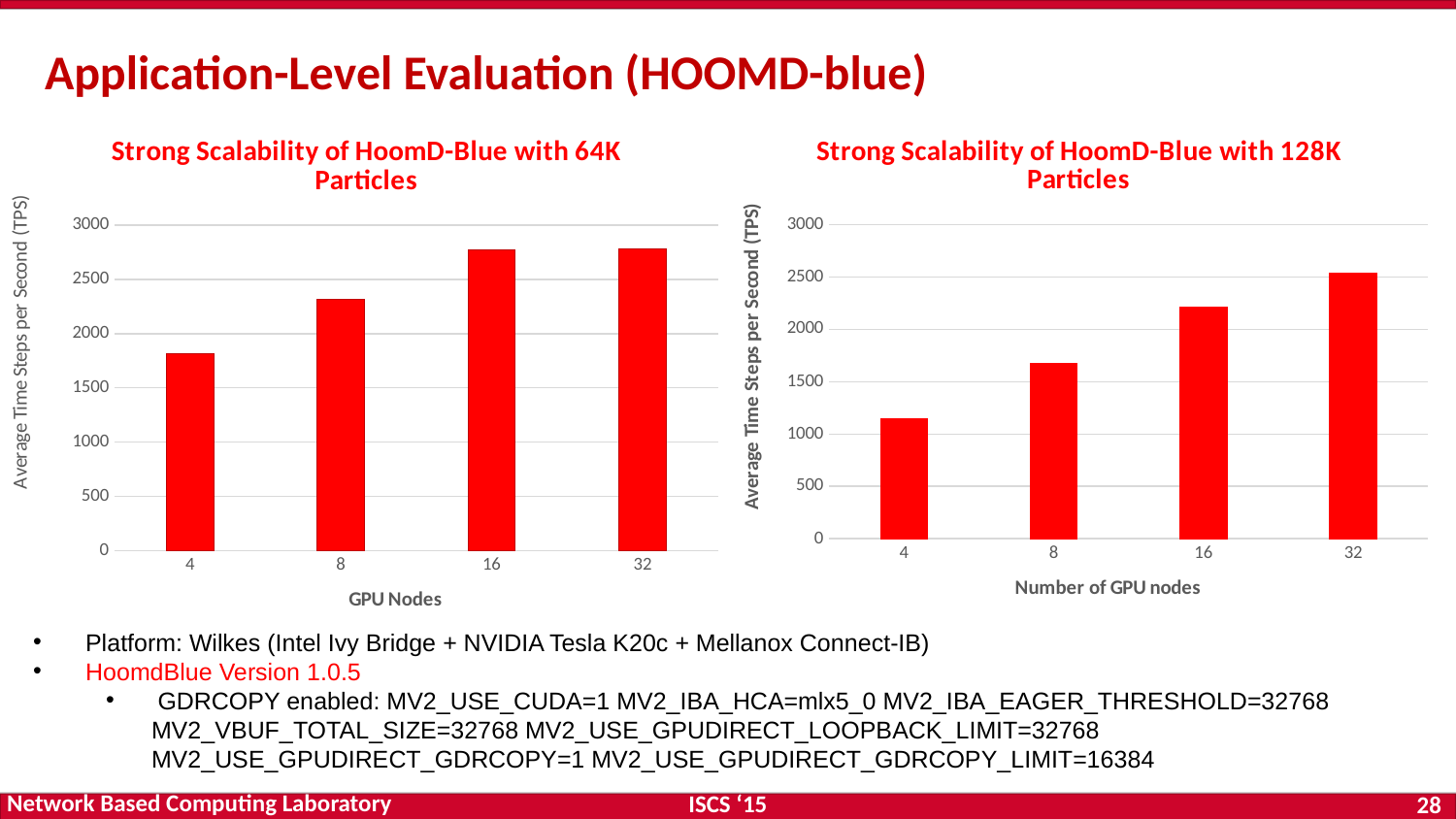
In the chart titled 'Strong Scalability of HoomD-Blue with 128K Particles', which number of GPU nodes has the lowest average time steps per second? 4 In the chart titled 'Strong Scalability of HoomD-Blue with 128K Particles', which number of GPU nodes has the highest average time steps per second? 32 In the chart titled 'Strong Scalability of HoomD-Blue with 128K Particles', do the values rise or fall as the number of GPU nodes increases? rise In the chart titled 'Strong Scalability of HoomD-Blue with 128K Particles', how many GPU node counts are plotted on the x axis? 4 In the chart titled 'Strong Scalability of HoomD-Blue with 128K Particles', what is the label of the x axis? Number of GPU nodes In the chart titled 'Strong Scalability of HoomD-Blue with 64K Particles', is the value for 4 GPU nodes greater or less than 2000? less In the chart titled 'Strong Scalability of HoomD-Blue with 64K Particles', which number of GPU nodes has the lowest average time steps per second? 4 In the chart titled 'Strong Scalability of HoomD-Blue with 64K Particles', which has the larger value: 8 GPU nodes or 16 GPU nodes? 16 In the chart titled 'Strong Scalability of HoomD-Blue with 128K Particles', is the value for 4 GPU nodes greater or less than 1500? less In the chart titled 'Strong Scalability of HoomD-Blue with 64K Particles', is the value for 8 GPU nodes greater or less than 2000? greater In the chart titled 'Strong Scalability of HoomD-Blue with 64K Particles', what kind of chart is shown? bar chart